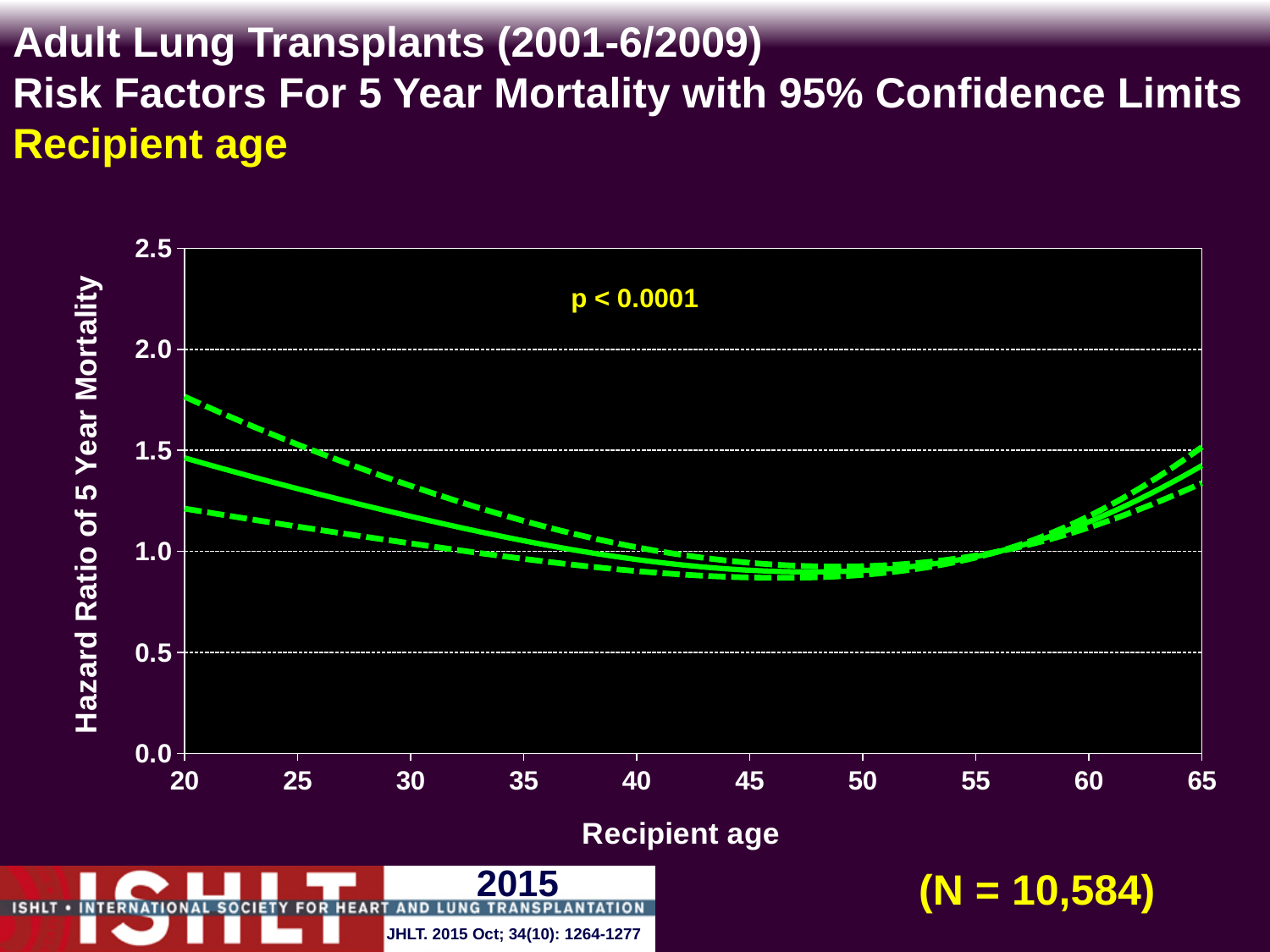
Is the value of the solid hazard ratio line at recipient age 45 greater or less than 1.0? less Is the value of the solid hazard ratio line at recipient age 65 greater or less than 1.0? greater What p-value is printed on the chart? p < 0.0001 Does the solid hazard ratio line rise or fall as recipient age increases from 20 to 45? fall Does the solid hazard ratio line rise or fall as recipient age increases from 55 to 65? rise Is the value of the upper dashed confidence limit at recipient age 20 greater or less than 1.5? greater How many tick labels are shown on the x axis? 10 How many lines are plotted on the chart? 3 What kind of chart is shown on the slide? Line chart What is the sample size (N) shown on the slide? N = 10,584 What is the label of the y axis? Hazard Ratio of 5 Year Mortality What is the label of the x axis? Recipient age